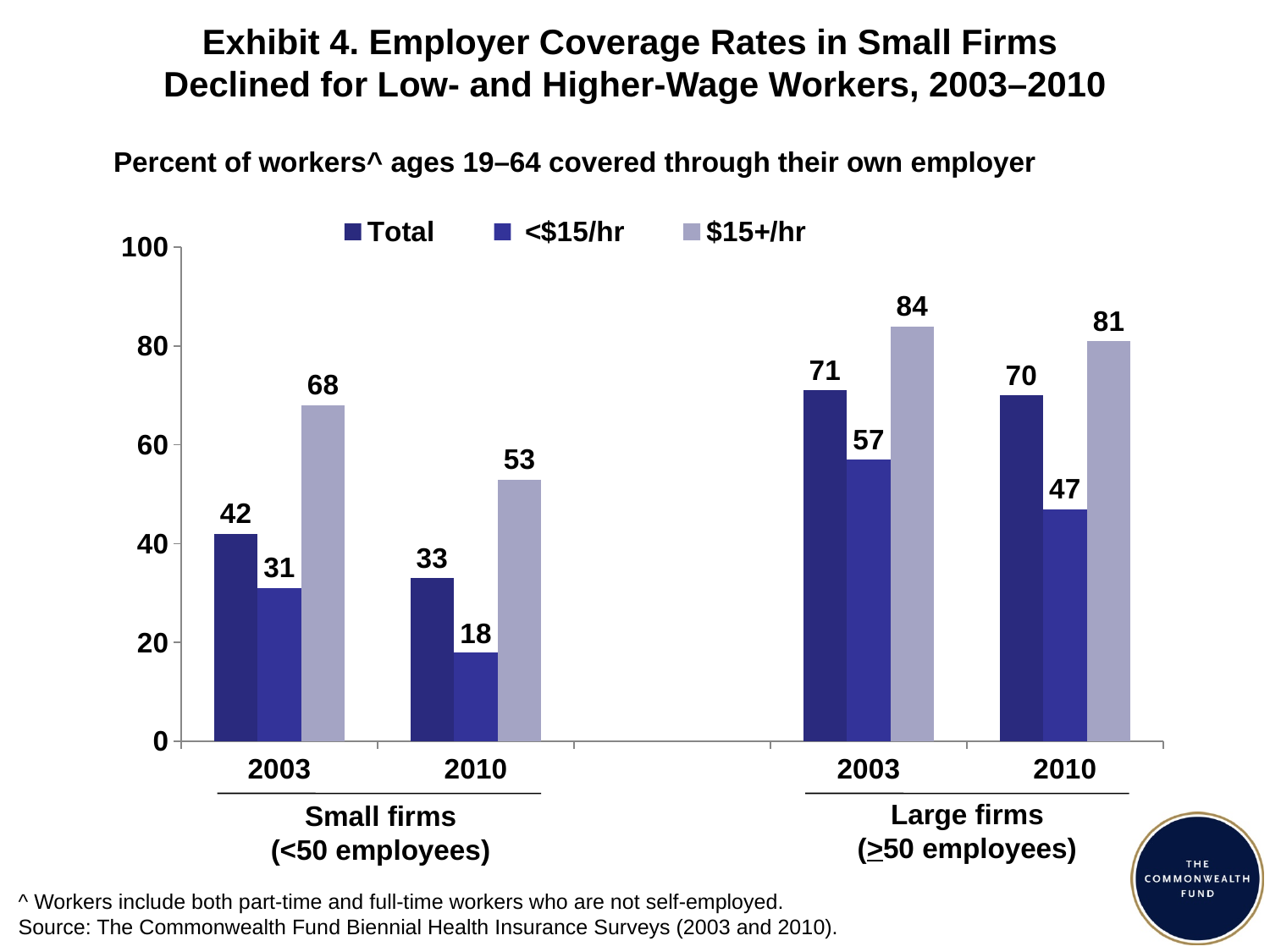
What is the Total coverage rate for small firms in 2003? 42 Which group and year has the highest coverage rate on the chart? $15+/hr, large firms, 2003 What kind of chart is shown on the slide? Bar chart What is the value for $15+/hr workers in large firms in 2003? 84 Which is larger: the Total rate for small firms in 2003 or the <$15/hr rate for large firms in 2010? <$15/hr rate for large firms in 2010 What is the difference between the $15+/hr rate and the <$15/hr rate in large firms in 2010? 34 What is the value for <$15/hr workers in small firms in 2010? 18 Did the $15+/hr coverage rate in small firms rise or fall from 2003 to 2010? Fall Which group and year has the lowest coverage rate on the chart? <$15/hr, small firms, 2010 What is the Total coverage rate for large firms in 2010? 70 By how much did the <$15/hr coverage rate in small firms fall from 2003 to 2010? 13 How many series does the legend list? 3